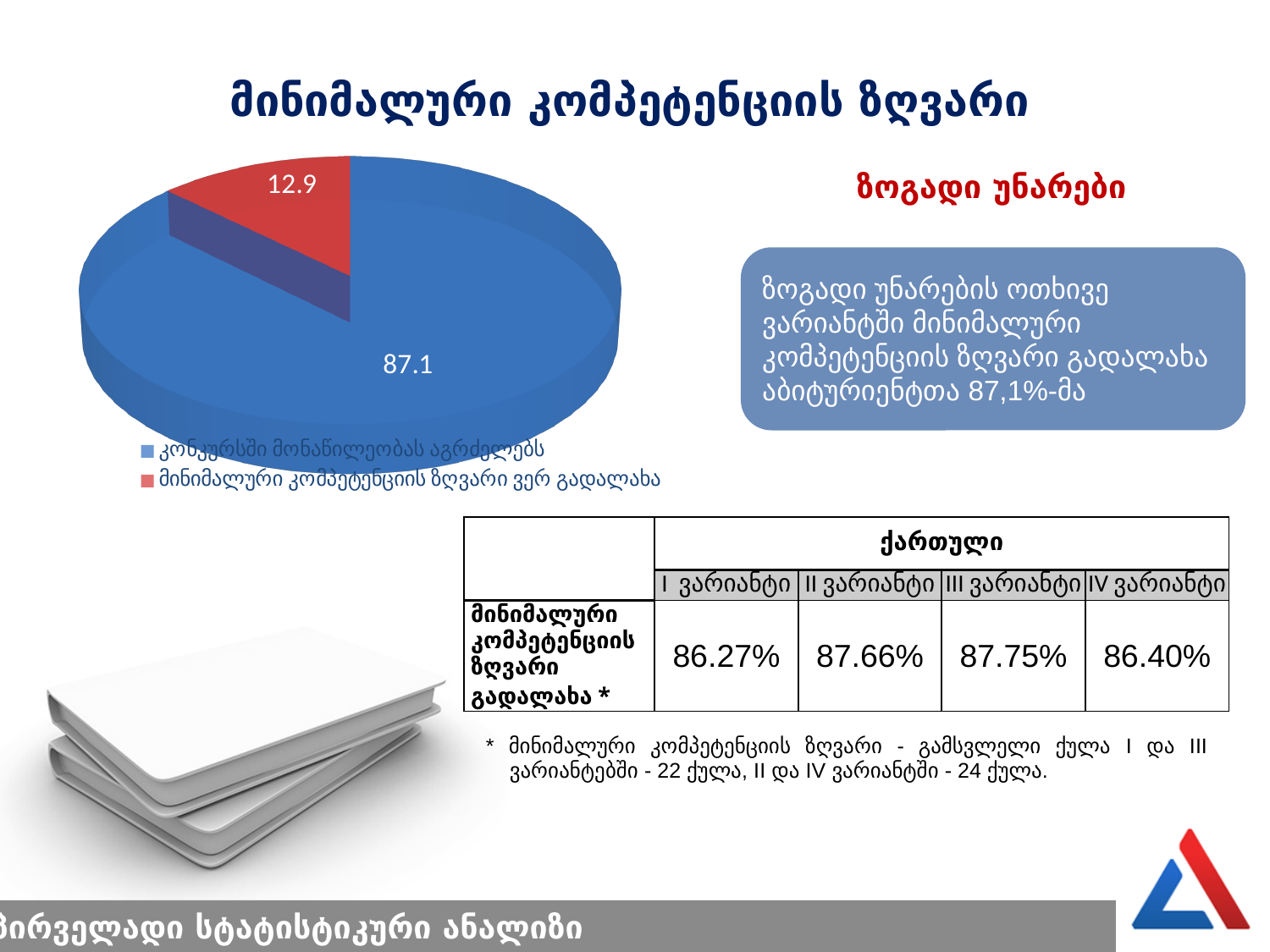
What kind of chart is shown on the slide? pie chart What colour is the slice labelled 12.9 in the pie chart? red What is the value of the slice labelled "კონკურსში მონაწილეობას აგრძელებს"? 87.1 Which slice of the pie chart is the largest? კონკურსში მონაწილეობას აგრძელებს How many entries does the pie chart legend list? 2 What is the value of the slice labelled "მინიმალური კომპეტენციის ზღვარი ვერ გადალახა"? 12.9 Which is larger: the slice for "კონკურსში მონაწილეობას აგრძელებს" or the slice for "მინიმალური კომპეტენციის ზღვარი ვერ გადალახა"? კონკურსში მონაწილეობას აგრძელებს What is the difference between the two slice values in the pie chart? 74.2 What is the total of the two slice values shown in the pie chart? 100 Which slice of the pie chart is the smallest? მინიმალური კომპეტენციის ზღვარი ვერ გადალახა How many slices does the pie chart have? 2